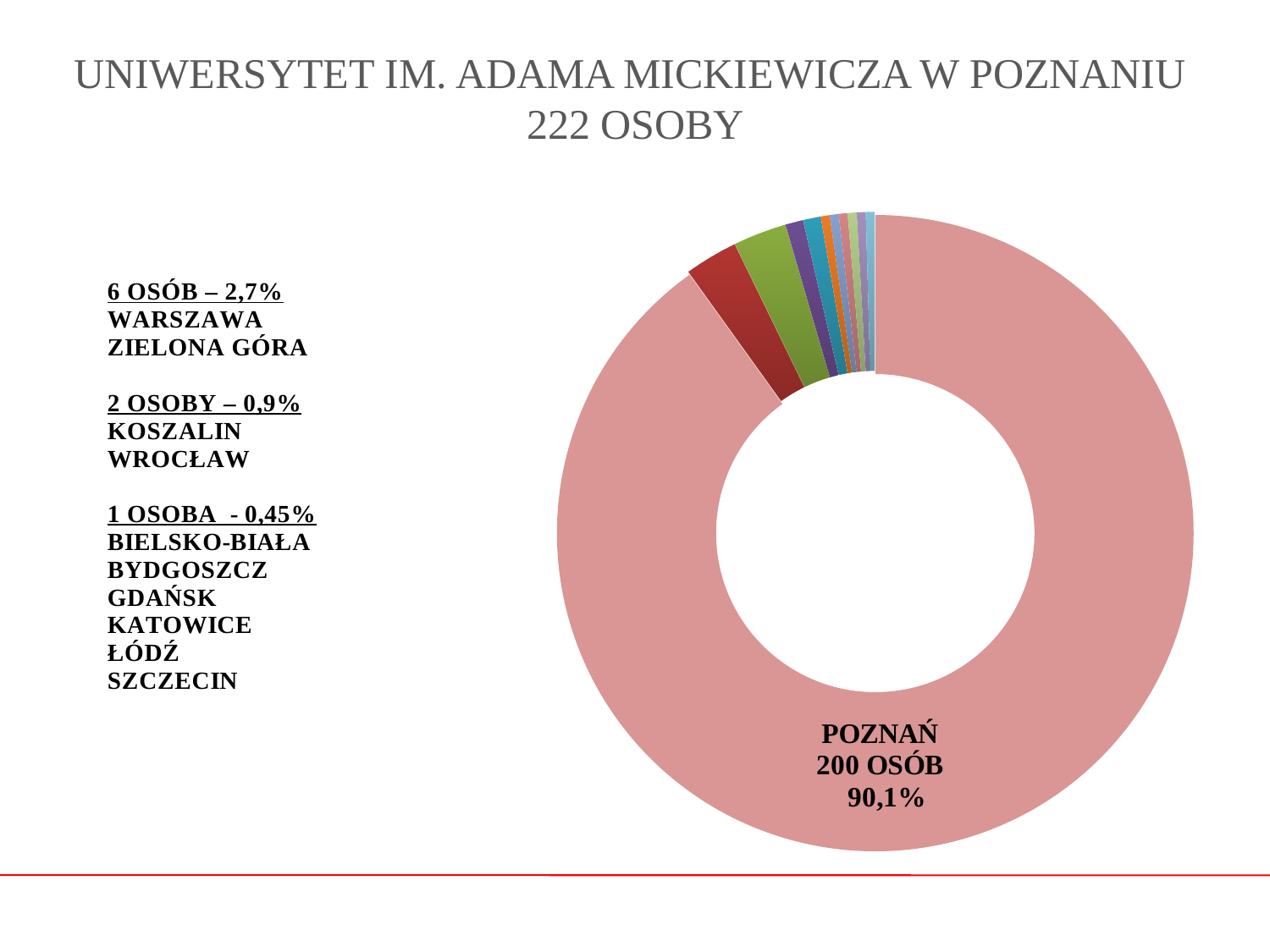
What is the difference in number of people between Poznań and Warszawa? 194 How many people are from Koszalin? 2 osoby What share of the chart do Warszawa and Zielona Góra each account for? 2,7% What is the title of the chart on the slide? UNIWERSYTET IM. ADAMA MICKIEWICZA W POZNANIU 222 OSOBY Which is larger, the slice for Poznań or the slice for Wrocław? Poznań Which city has the largest slice of the chart? Poznań What kind of chart is shown on the slide? pie chart (doughnut) What is the total number of people represented in the chart? 222 osoby How many people does the Poznań slice represent? 200 osób What share of the pie does Poznań account for? 90,1% What share of the chart does Bielsko-Biała account for? 0,45% How many cities are listed as having 1 person (0,45%)? 6